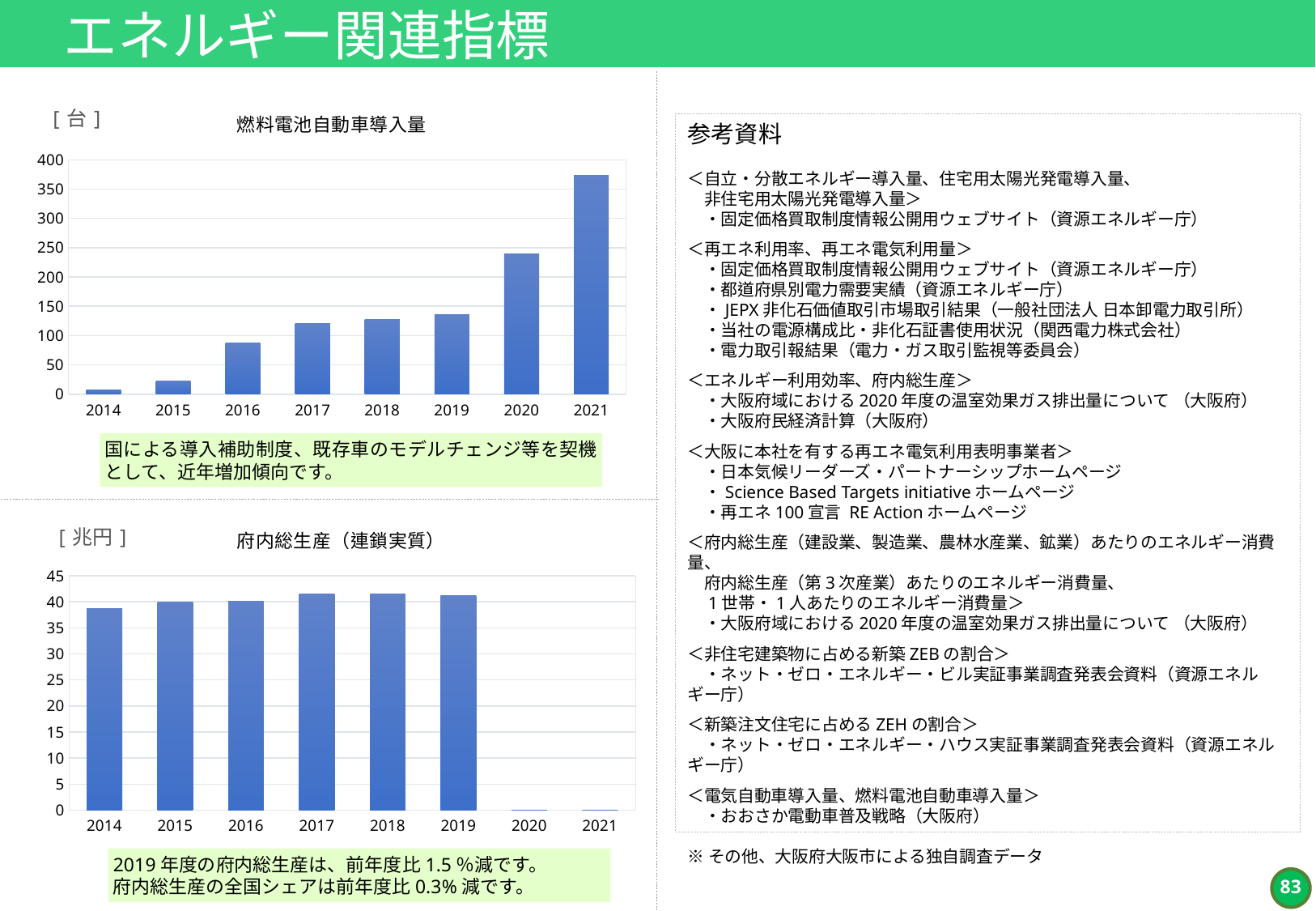
What kind of chart is the 府内総生産（連鎖実質） chart? bar chart What unit is shown for the 燃料電池自動車導入量 chart? 台 In the 府内総生産（連鎖実質） chart, is the value for 2014 greater or less than 40? less How many years are shown on the x axis of the 燃料電池自動車導入量 chart? 8 In the 燃料電池自動車導入量 chart, do the values rise or fall from 2014 to 2021? rise In the 燃料電池自動車導入量 chart, which year has the highest value? 2021 In the 燃料電池自動車導入量 chart, is the value for 2020 greater or less than 200? greater What kind of chart is the 燃料電池自動車導入量 chart? bar chart In the 燃料電池自動車導入量 chart, is the value for 2016 greater or less than 100? less In the 燃料電池自動車導入量 chart, which year has the lowest value? 2014 In the 府内総生産（連鎖実質） chart, which is larger, the value for 2014 or the value for 2017? 2017